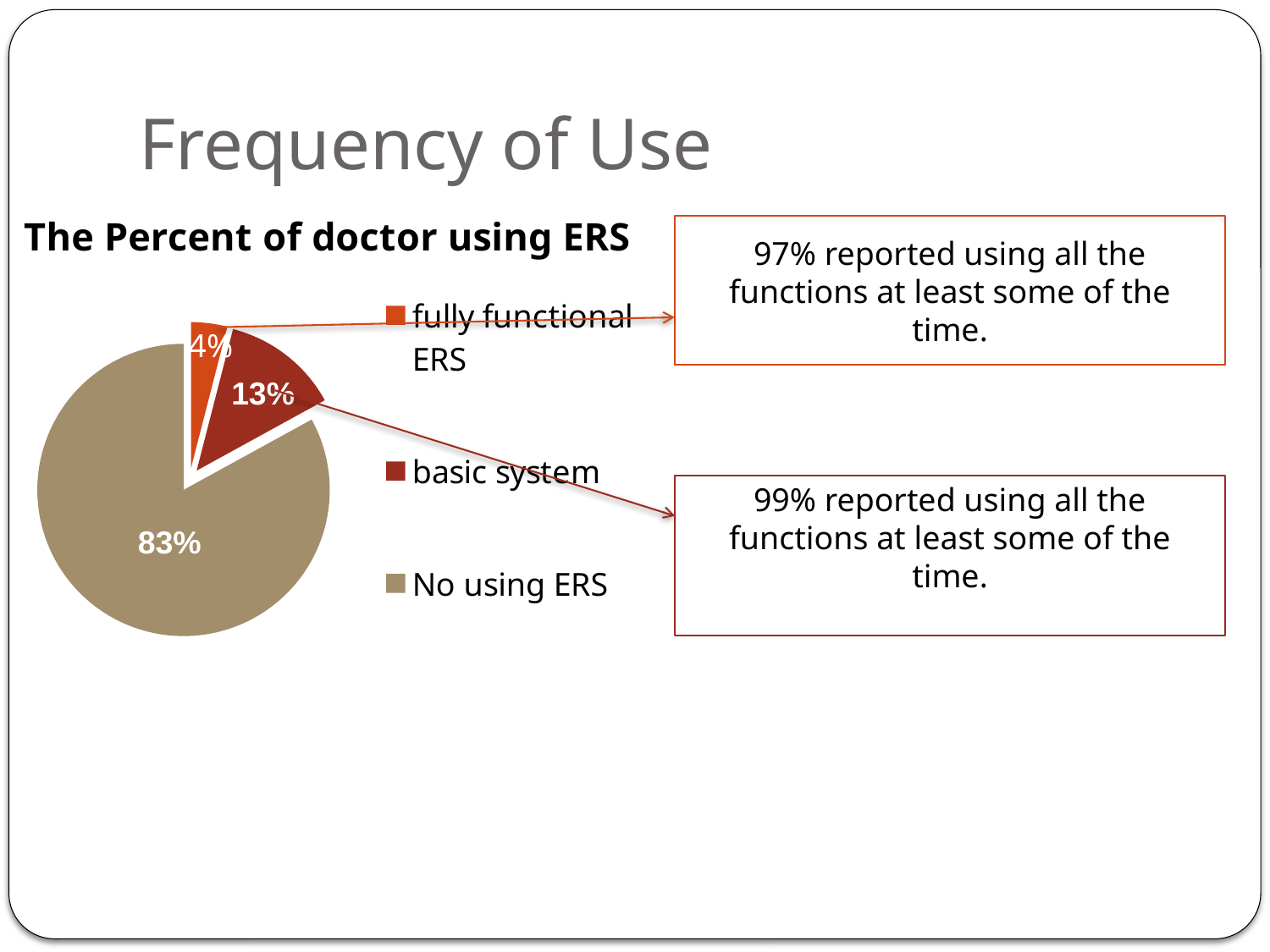
What is the title of the chart? The Percent of doctor using ERS What is the difference between the share for basic system and the share for fully functional ERS? 9% What percentage of doctors use a fully functional ERS? 4% Which is larger, the share for basic system or the share for fully functional ERS? basic system Which category has the smallest share of the pie? fully functional ERS What type of chart is shown on the slide? pie chart Which category has the largest share of the pie? No using ERS Which legend entry is shown in the tan/brown colour? No using ERS What percentage of doctors are not using ERS? 83% How many categories does the pie chart show? 3 What percentage of doctors use a basic system? 13% What is the difference between the share for No using ERS and the share for basic system? 70%